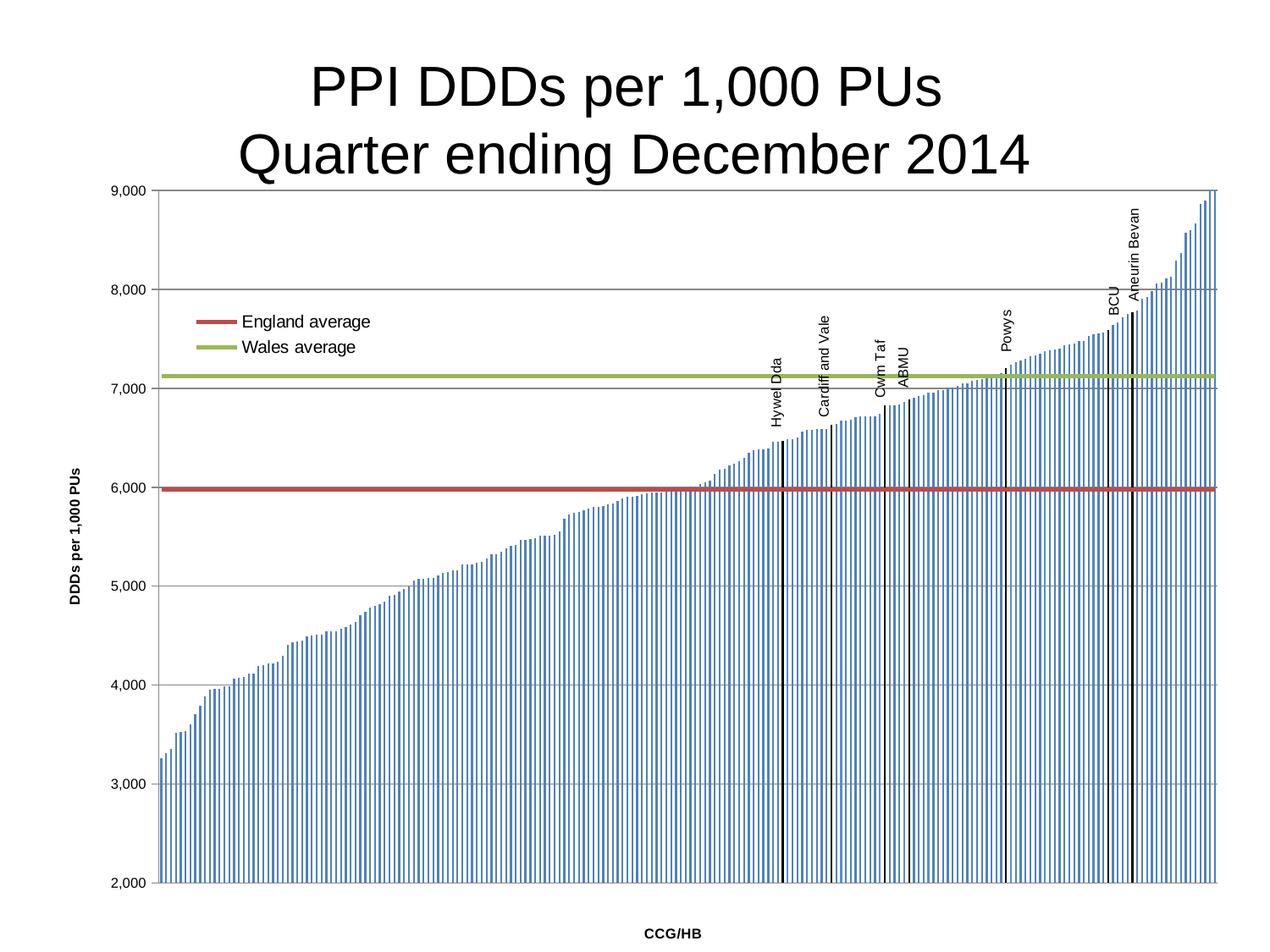
Is the value for Hywel Dda greater or less than 6,000? greater Of the labelled health boards, which has the highest value? Aneurin Bevan Which has the larger value, Aneurin Bevan or Hywel Dda? Aneurin Bevan Do the bar values rise or fall from left to right along the x axis? rise Which is higher, the Wales average line or the England average line? Wales average Is the value for BCU greater or less than 7,000? greater Of the labelled health boards, which has the lowest value? Hywel Dda How many entries does the legend list? 2 Is the value for Aneurin Bevan greater or less than 8,000? less What is the title of the chart? PPI DDDs per 1,000 PUs Quarter ending December 2014 What kind of chart is shown on the slide? bar chart